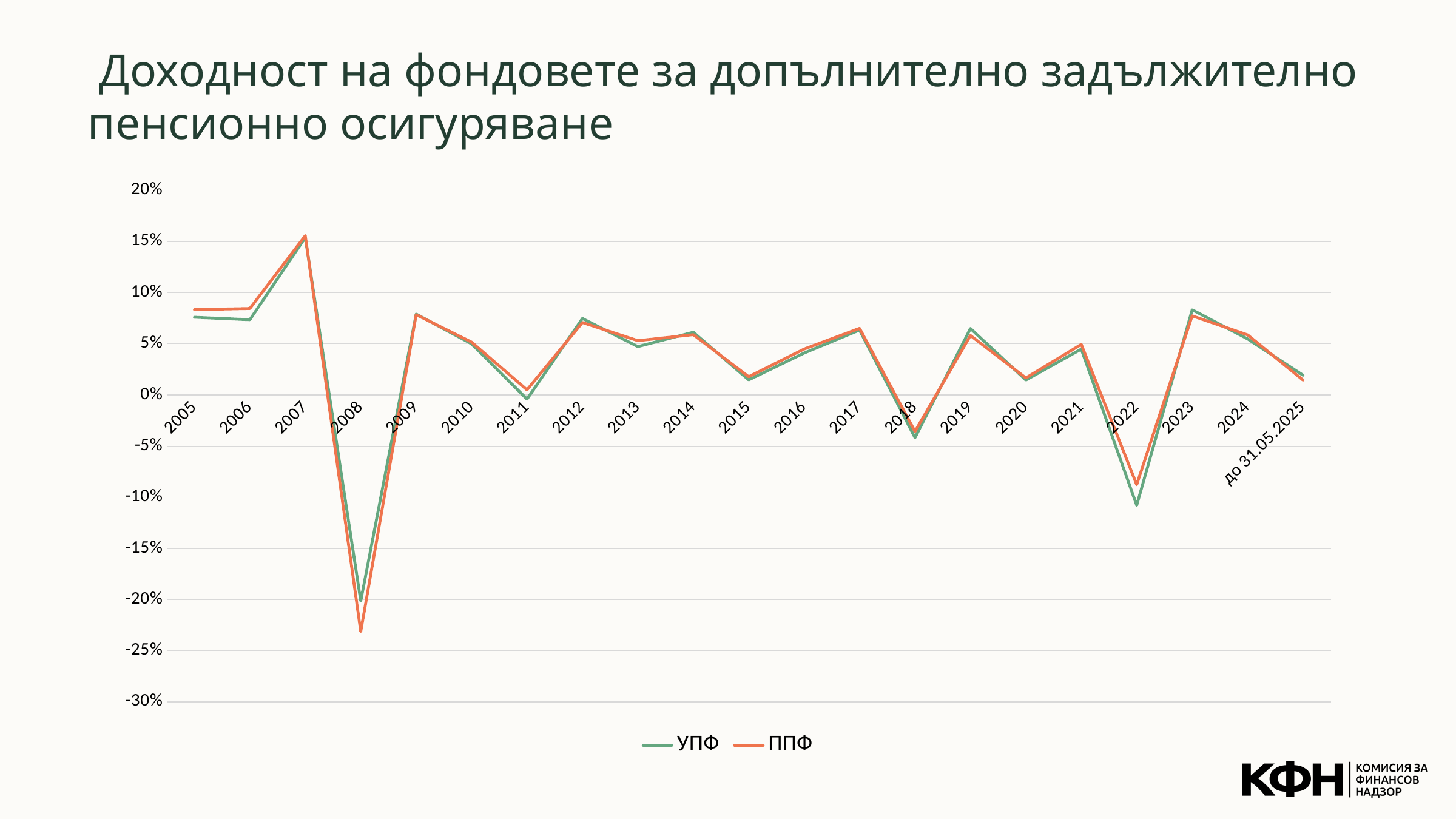
Is the value for УПФ in 2007 greater or less than 10%? greater In 2008, which series has the lower value, УПФ or ППФ? ППФ How many series does the legend list? 2 Is the value for ППФ in 2008 greater or less than -20%? less Is the value for УПФ in 2018 greater or less than 0%? less In which year does the УПФ series reach its lowest value? 2008 How many points are plotted along the x axis for each series? 21 In 2022, which series has the lower value, УПФ or ППФ? УПФ Do the values of the ППФ series rise or fall from 2005 to 2007? rise Which two series are listed in the legend? УПФ and ППФ In which year does the ППФ series reach its highest value? 2007 What kind of chart is shown on the slide? line chart